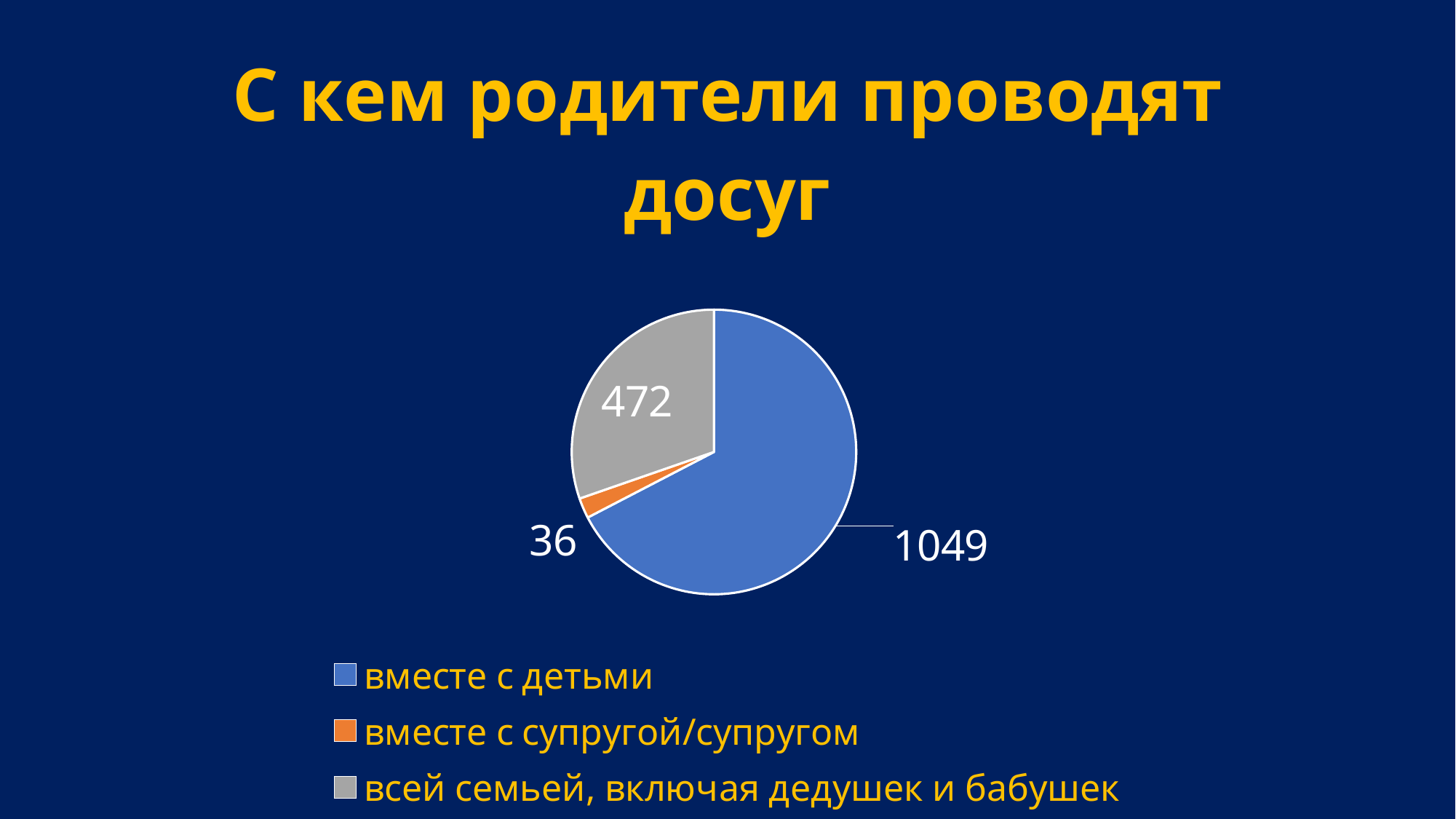
What colour is the slice for "всей семьей, включая дедушек и бабушек"? grey What is the value for "вместе с детьми"? 1049 What type of chart is shown on the slide? pie chart Which is larger: the value for "всей семьей, включая дедушек и бабушек" or the value for "вместе с супругой/супругом"? всей семьей, включая дедушек и бабушек How many categories does the pie chart have? 3 What is the value for "вместе с супругой/супругом"? 36 Which category has the largest slice of the pie? вместе с детьми What is the value for "всей семьей, включая дедушек и бабушек"? 472 What is the title of the chart on the slide? С кем родители проводят досуг What is the difference between the values for "вместе с детьми" and "всей семьей, включая дедушек и бабушек"? 577 Which category has the smallest slice of the pie? вместе с супругой/супругом What is the difference between the values for "всей семьей, включая дедушек и бабушек" and "вместе с супругой/супругом"? 436